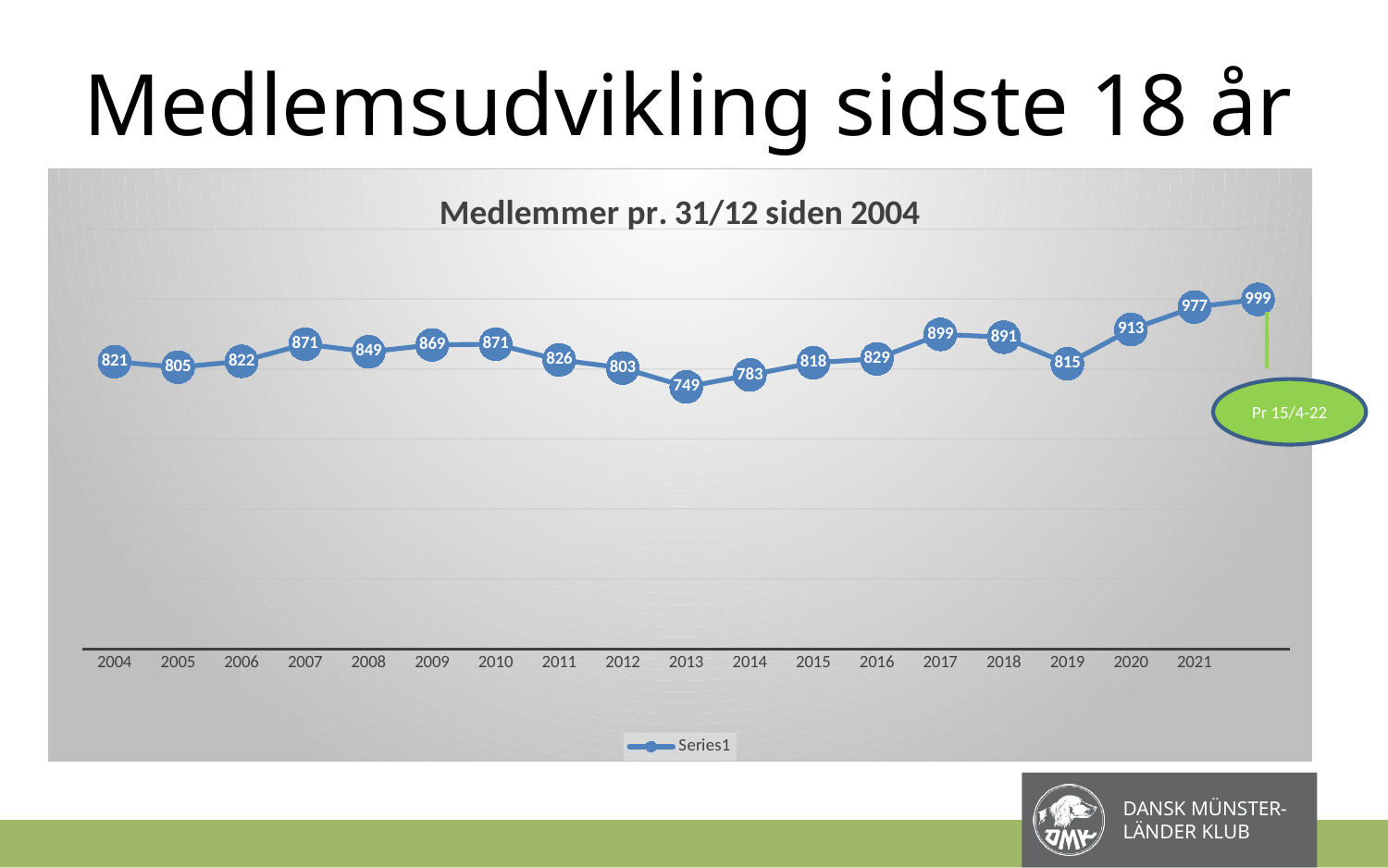
What is the value for 2004? 821 What is the value for 2017? 899 Which is larger, the value for 2018 or the value for 2019? 2018 What is the title of the chart? Medlemmer pr. 31/12 siden 2004 Which year has the lowest value? 2013 How many years are labeled on the x axis? 18 How many series does the legend list? 1 What is the difference between the values for 2021 and 2020? 64 What type of chart is shown on the slide? line chart What is the value for 2021? 977 What is the value for 2013? 749 What is the highest value plotted on the chart? 999